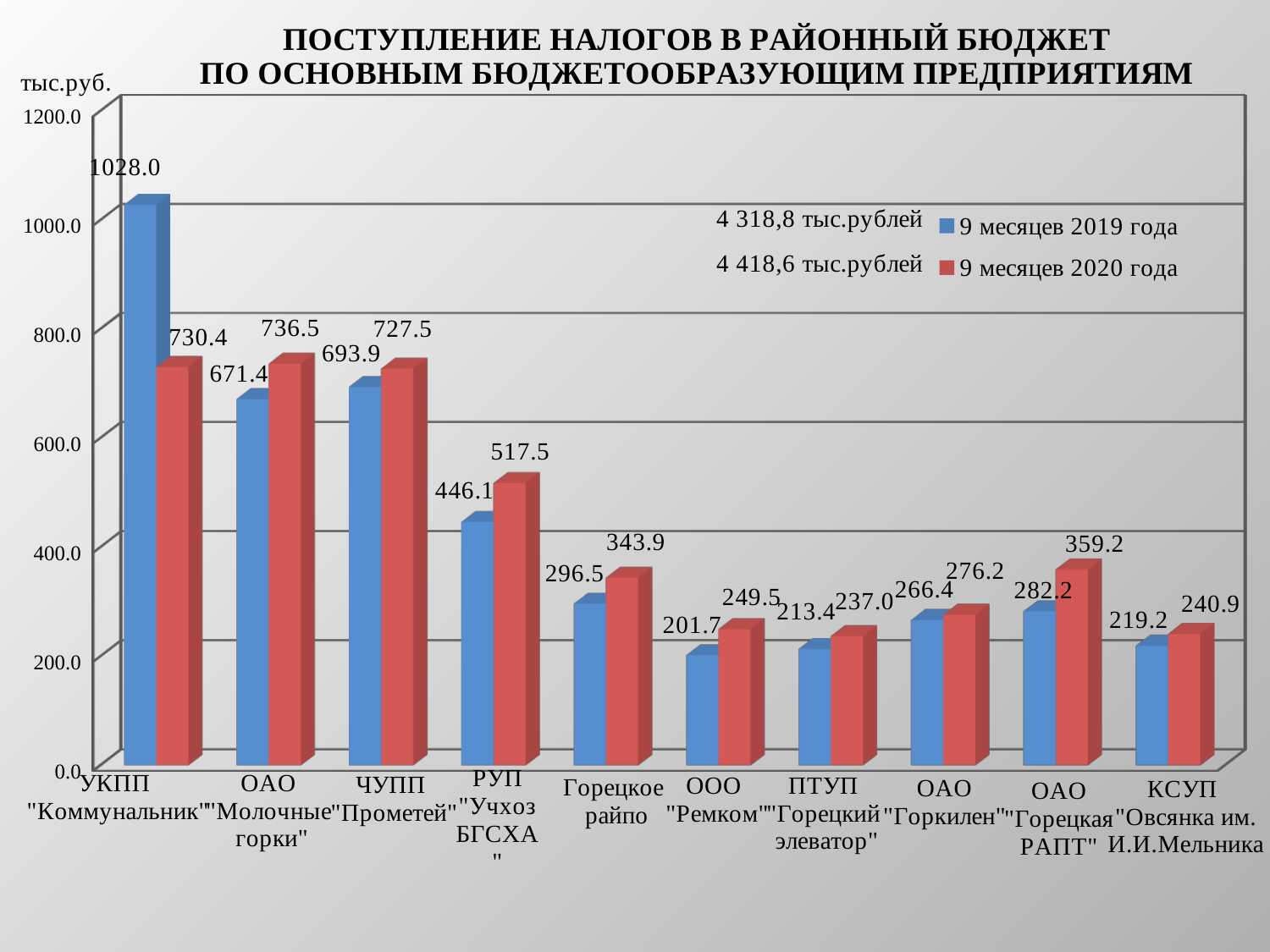
What kind of chart is shown on the slide? Bar chart Which enterprise has the lowest value in the "9 месяцев 2019 года" series? ООО "Ремком" What is the value for ОАО "Молочные горки" in the "9 месяцев 2020 года" series? 736.5 How many series does the legend list? 2 What is the value for РУП "Учхоз БГСХА" in the "9 месяцев 2019 года" series? 446.1 What is the value for ОАО "Горецкая РАПТ" in the "9 месяцев 2020 года" series? 359.2 What is the value for УКПП "Коммунальник" in the "9 месяцев 2019 года" series? 1028.0 Which enterprise has the highest value in the "9 месяцев 2019 года" series? УКПП "Коммунальник" How many enterprises are shown on the x axis? 10 For УКПП "Коммунальник", which is larger: the 2019 value or the 2020 value? 2019 value (1028.0) What unit is shown on the vertical axis label? тыс.руб. What is the difference between the 2020 and 2019 values for ЧУПП "Прометей"? 33.6